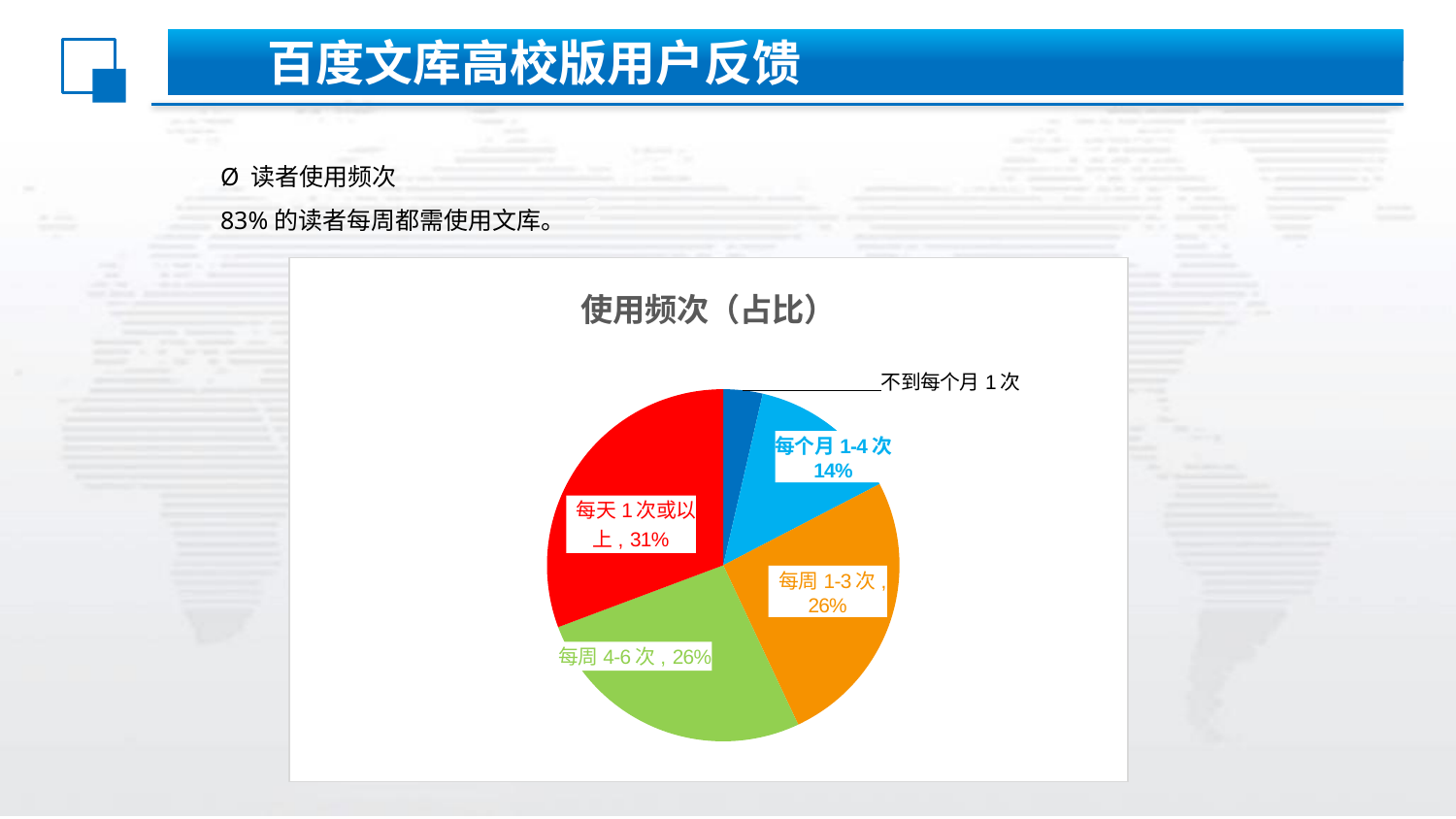
Which category has the largest slice of the pie? 每天1次或以上 What is the title of the chart? 使用频次（占比） What share of the pie is labelled 每个月1-4次? 14% How many slices does the pie chart have? 5 What is the difference between the shares for 每天1次或以上 and 每个月1-4次? 17% What colour is the slice for 每周4-6次? green What kind of chart is shown on the slide? pie chart What share of the pie is labelled 每天1次或以上? 31% Which is larger, the share for 每周1-3次 or the share for 每个月1-4次? 每周1-3次 Which category has the smallest slice of the pie? 不到每个月1次 What share of the pie is labelled 每周1-3次? 26% What share of the pie is labelled 每周4-6次? 26%